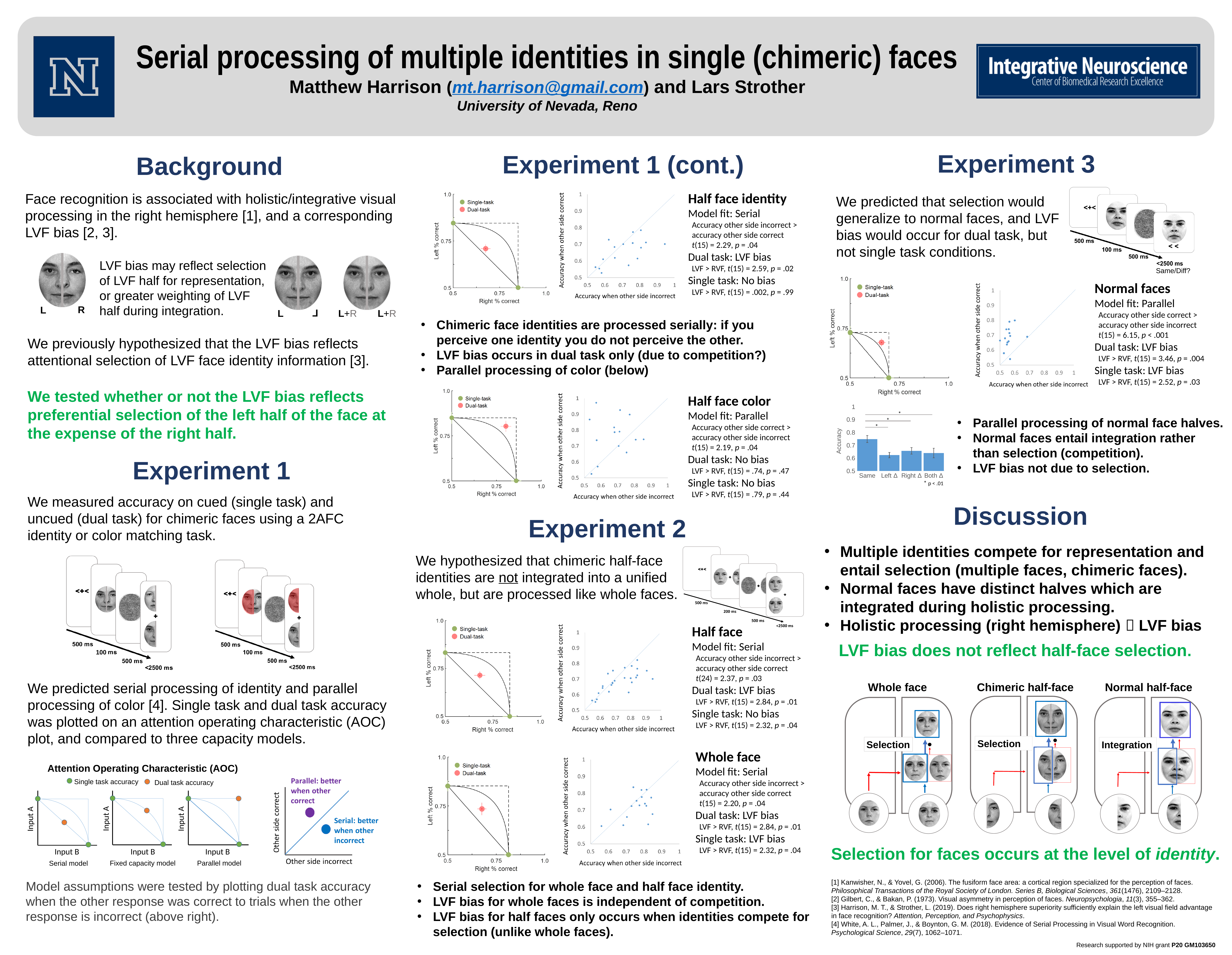
What kind of chart is the Accuracy chart in the Experiment 3 section with categories Same, Left Δ, Right Δ and Both Δ? bar chart What is the y-axis label of the bar chart in the Experiment 3 section? Accuracy In the Whole face AOC plot in the Experiment 2 section, is the Right % correct value of the Dual-task point greater or less than 0.75? less In the Experiment 3 bar chart of Accuracy, which category has the highest bar? Same What are the two legend entries in the Half face color AOC plot in the Experiment 1 (cont.) section? Single-task, Dual-task In the Experiment 3 bar chart of Accuracy, which is larger, the value for Same or the value for Right Δ? Same In the Experiment 3 bar chart of Accuracy, is the value for Same greater or less than 0.7? greater How many series does the legend list in the Half face identity AOC plot in the Experiment 1 (cont.) section? 2 In the Experiment 3 bar chart of Accuracy, how many categories are shown on the x axis? 4 In the Experiment 3 AOC plot, is the Left % correct value of the Dual-task point greater or less than 0.75? less